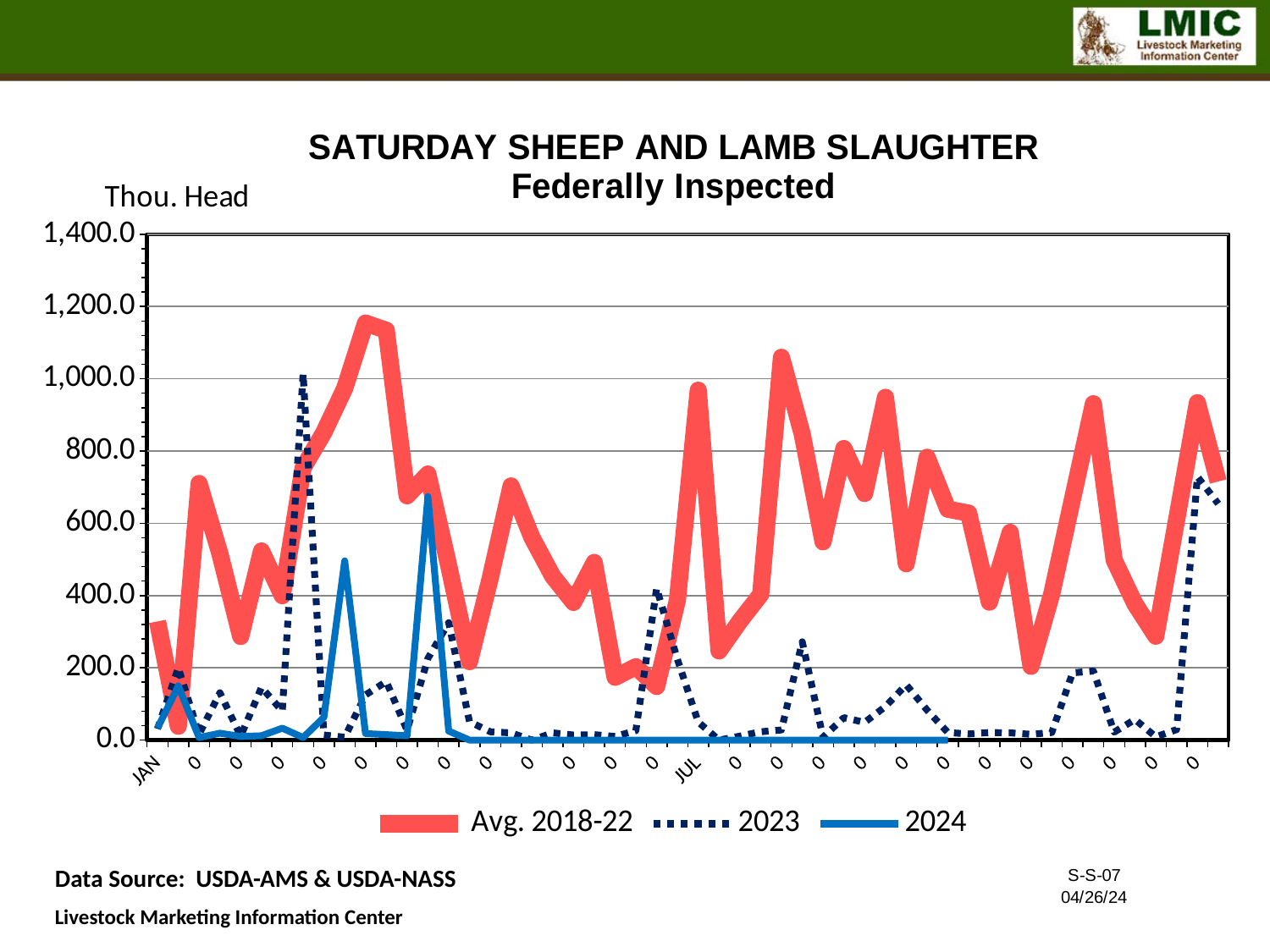
Is the highest value of the 2023 series greater or less than 800.0? greater Which series reaches the highest value on the chart? Avg. 2018-22 What are the three series listed in the legend? Avg. 2018-22, 2023, 2024 Is the Avg. 2018-22 value at JAN greater or less than 200.0? greater Which series stays lowest for most of the year? 2024 Is the 2023 value at JAN greater or less than 200.0? less At JUL, which series is higher, Avg. 2018-22 or 2023? Avg. 2018-22 What kind of chart is shown on the slide? line chart How many series does the legend list? 3 What unit label is shown on the y axis? Thou. Head